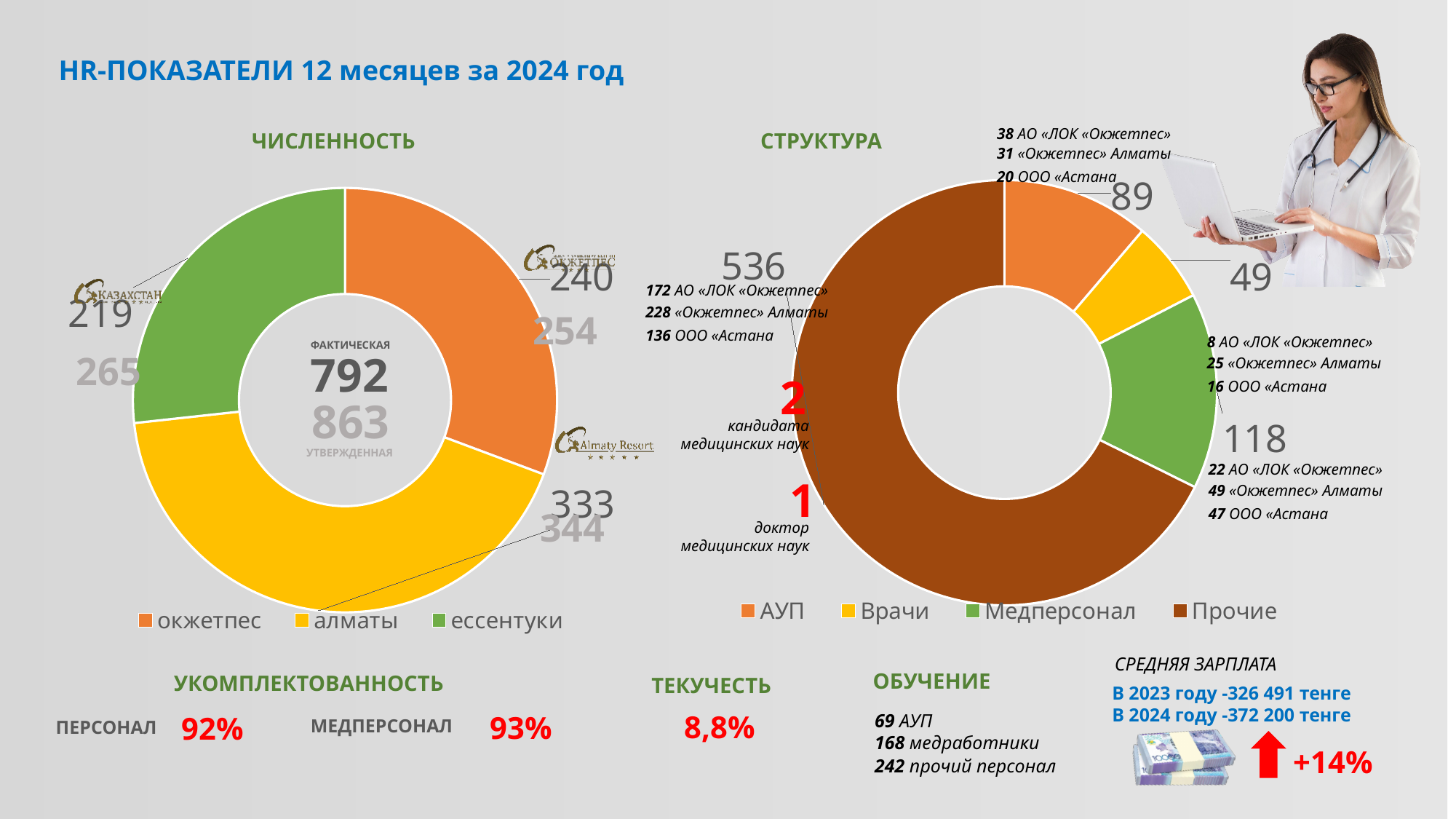
On the СТРУКТУРА chart, what is the value for Прочие? 536 What kind of chart is the ЧИСЛЕННОСТЬ chart? Donut (pie) chart On the ЧИСЛЕННОСТЬ chart, what is the value for алматы? 333 How many entries does the legend of the СТРУКТУРА chart list? 4 On the ЧИСЛЕННОСТЬ chart, which category has the lowest value? ессентуки On the ЧИСЛЕННОСТЬ chart, which category has the highest value? алматы On the ЧИСЛЕННОСТЬ chart, what is the фактическая total shown in the centre? 792 On the ЧИСЛЕННОСТЬ chart, what is the value for окжетпес? 240 On the СТРУКТУРА chart, what is the value for Врачи? 49 On the ЧИСЛЕННОСТЬ chart, what is the difference between the values for алматы and окжетпес? 93 On the СТРУКТУРА chart, which is larger, АУП or Медперсонал? Медперсонал On the СТРУКТУРА chart, which category has the largest value? Прочие